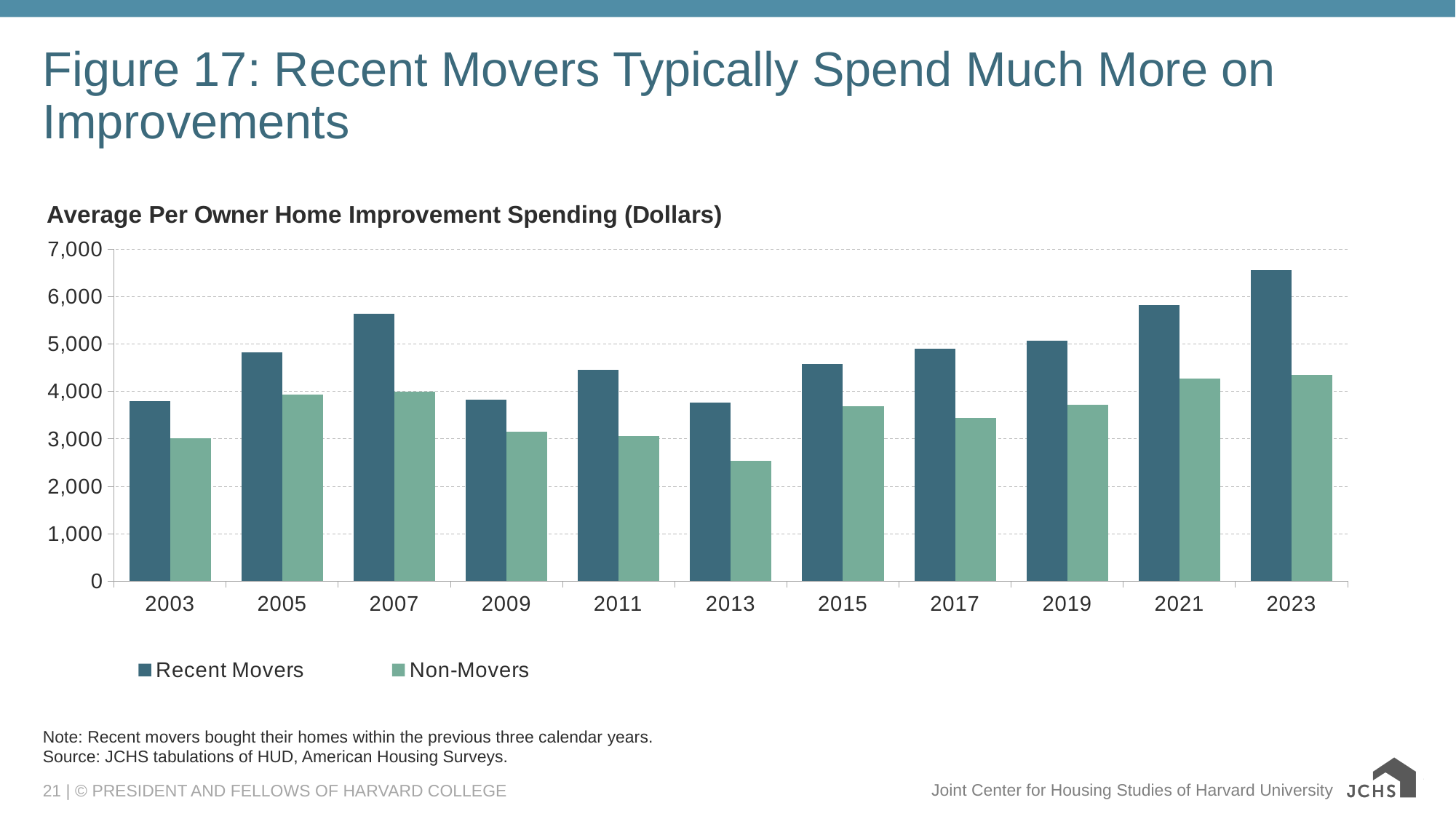
In which year is the Recent Movers value highest? 2023 Is the Recent Movers value for 2023 greater or less than 6,000? greater In which year is the Non-Movers value lowest? 2013 Is the Non-Movers value for 2013 greater or less than 3,000? less In 2007, which series has the larger value, Recent Movers or Non-Movers? Recent Movers What is the title of the chart? Average Per Owner Home Improvement Spending (Dollars) Is the Recent Movers value for 2007 greater or less than 5,000? greater How many years are shown on the x axis? 11 How many series does the legend list? 2 What kind of chart is shown on the slide? Bar chart Do the Recent Movers values rise or fall from 2019 to 2023? Rise